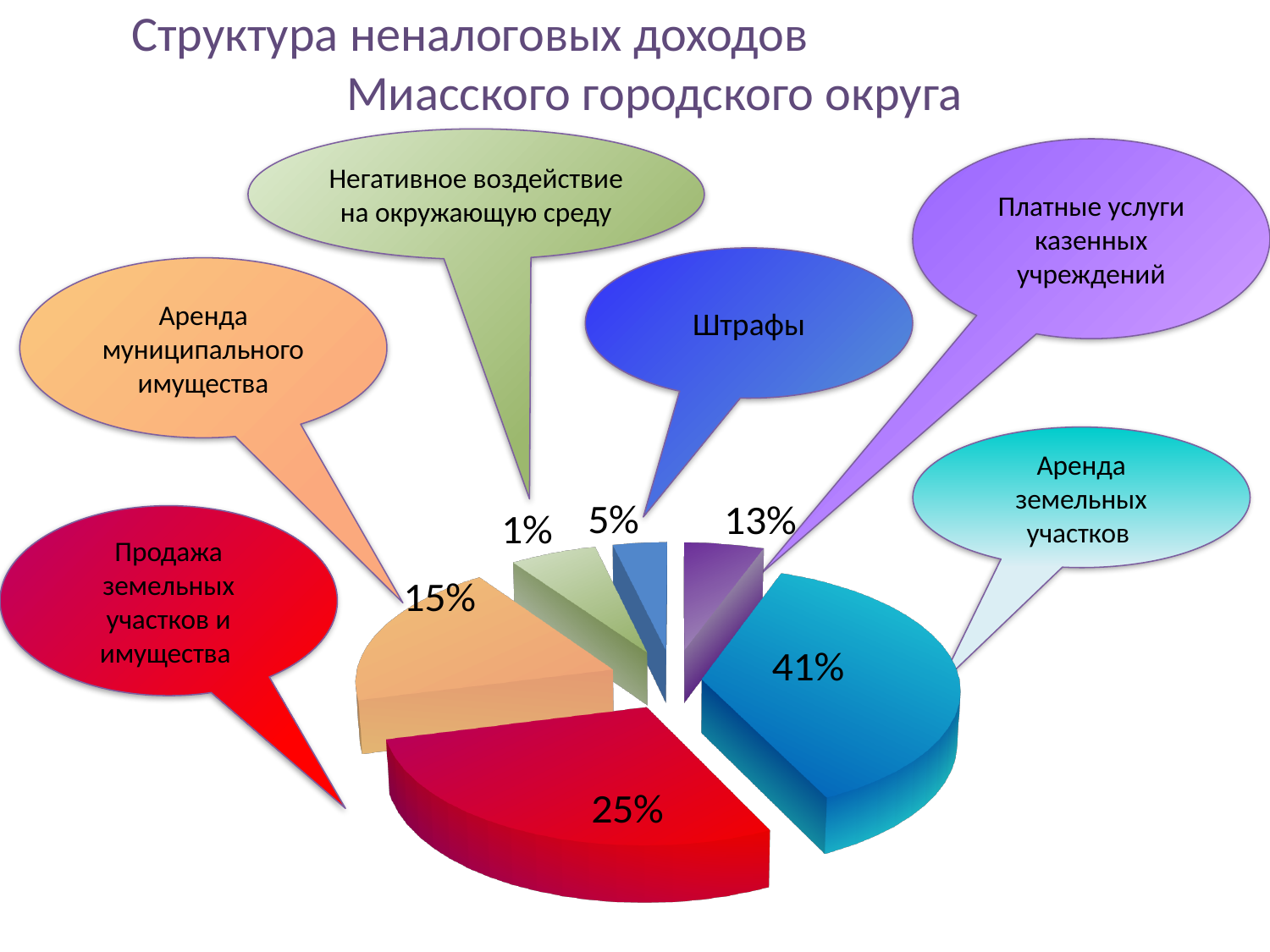
Which category has the smallest share of the pie? Негативное воздействие на окружающую среду What share of the pie is Штрафы? 5% What is the value for Платные услуги казенных учреждений? 13% What kind of chart is shown on the slide? pie chart How many slices does the pie chart have? 6 What is the title of the slide? Структура неналоговых доходов Миасского городского округа Which is larger: the share for Аренда муниципального имущества or the share for Платные услуги казенных учреждений? Аренда муниципального имущества What is the value for Аренда муниципального имущества? 15% What share of non-tax revenue comes from Аренда земельных участков? 41% What is the difference between the shares of Аренда земельных участков and Продажа земельных участков и имущества? 16% What share does Продажа земельных участков и имущества account for? 25% Which category has the largest share of the pie? Аренда земельных участков